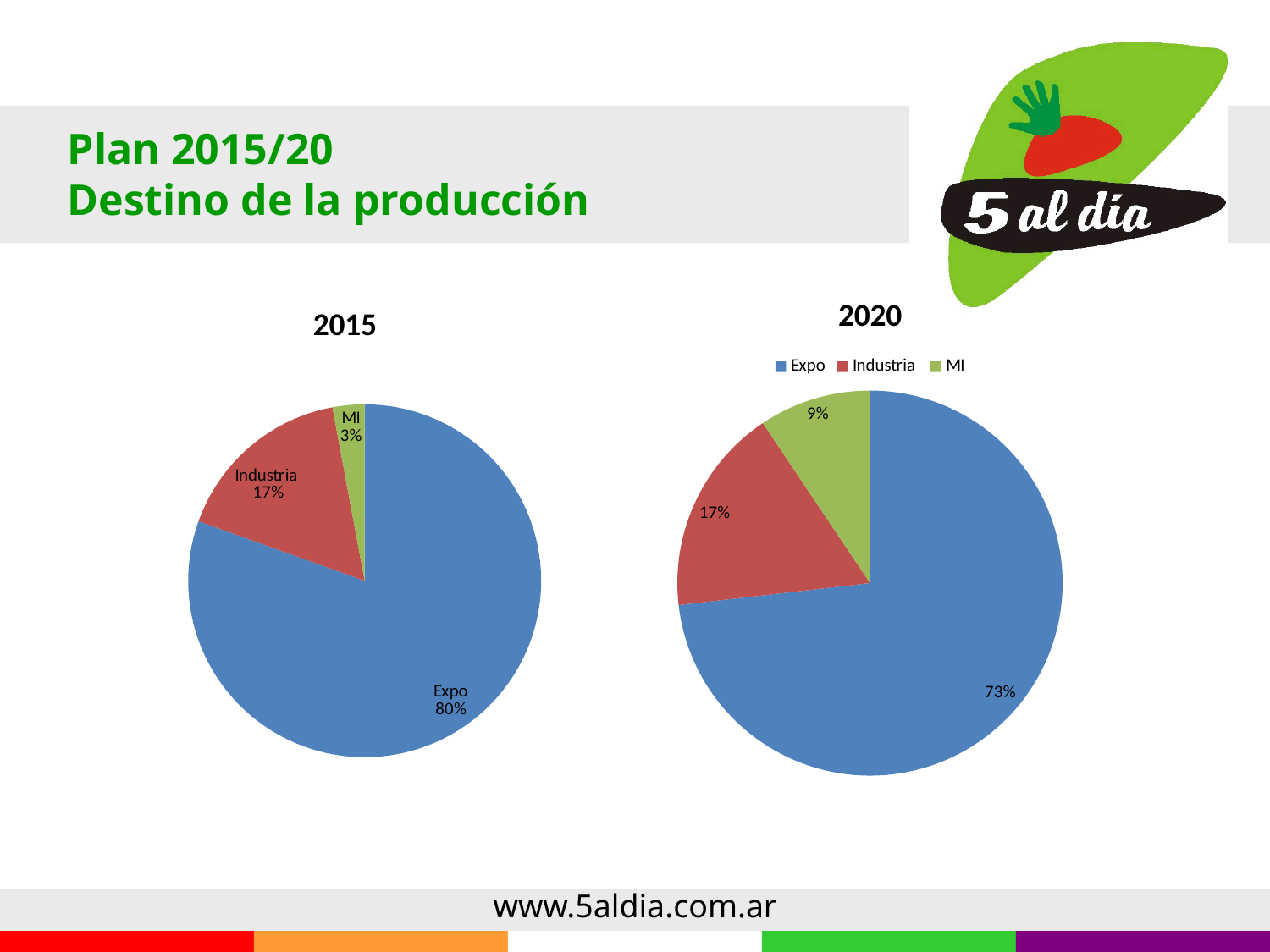
In the 2020 pie chart, what colour represents Industria? Red In the 2020 pie chart, what share does Expo have? 73% In the 2020 pie chart, which category has the smallest share? MI What is the difference between the Expo share in 2015 and the Expo share in 2020? 7 percentage points How many categories does the 2020 pie chart show? 3 In the 2015 pie chart, which category has the largest share? Expo In the 2015 pie chart, what share does Expo have? 80% In the 2020 pie chart, what share does MI have? 9% Is the MI share larger in the 2015 chart or the 2020 chart? 2020 What type of chart is the 2015 chart? Pie chart In the 2015 pie chart, what share does Industria have? 17% In the 2015 pie chart, what share does MI have? 3%